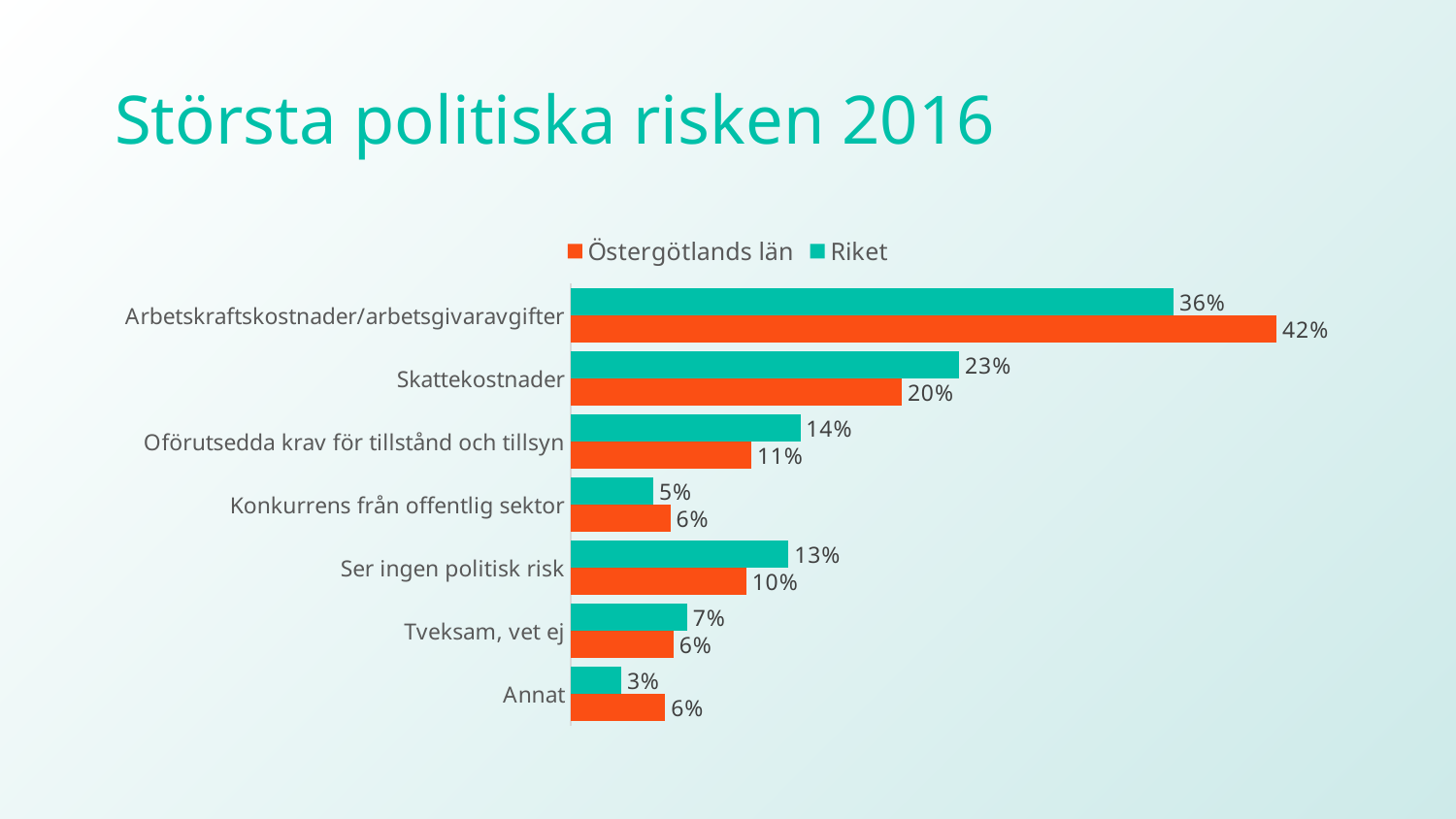
Which category has the highest value for Riket? Arbetskraftskostnader/arbetsgivaravgifter What is the value for Östergötlands län for Ser ingen politisk risk? 10% How many categories are shown in the chart? 7 What is the value for Östergötlands län for Arbetskraftskostnader/arbetsgivaravgifter? 42% What is the difference between Östergötlands län and Riket for Arbetskraftskostnader/arbetsgivaravgifter? 6% What is the title of the slide? Största politiska risken 2016 What kind of chart is shown on the slide? Bar chart Which category has the lowest value for Riket? Annat What is the difference between Riket and Östergötlands län for Oförutsedda krav för tillstånd och tillsyn? 3% What is the value for Riket for Skattekostnader? 23% How many series does the legend list? 2 Which is larger for Skattekostnader: Östergötlands län or Riket? Riket